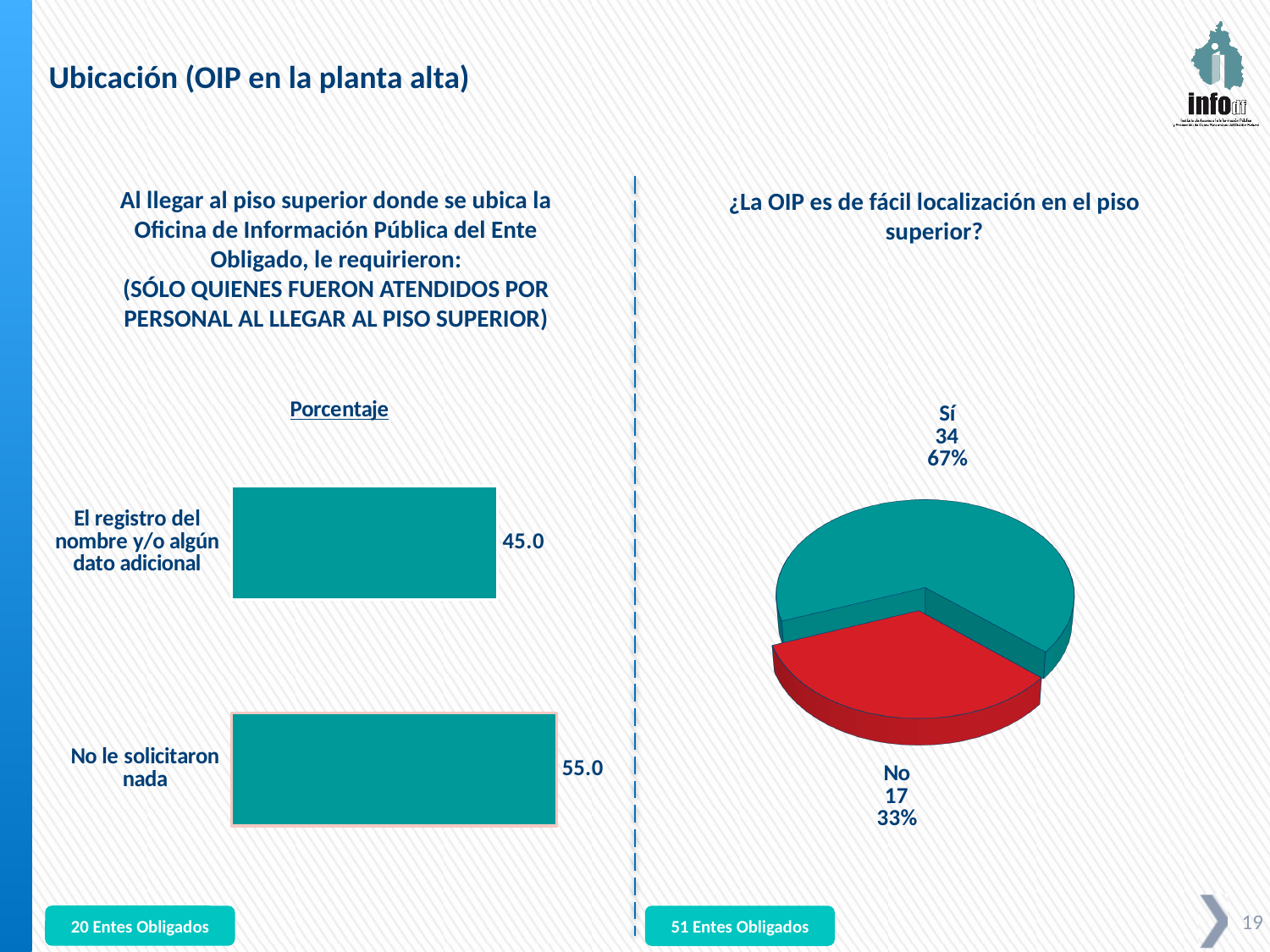
In the right chart '¿La OIP es de fácil localización en el piso superior?', what is the count for 'No'? 17 In the left chart, which category has the lowest value? El registro del nombre y/o algún dato adicional In the left chart, what is the value for 'El registro del nombre y/o algún dato adicional'? 45.0 In the right chart '¿La OIP es de fácil localización en el piso superior?', which slice is larger, 'Sí' or 'No'? Sí In the left chart, which category has the highest value? No le solicitaron nada In the left chart, what is the difference between 'No le solicitaron nada' and 'El registro del nombre y/o algún dato adicional'? 10.0 In the left chart, what is the value for 'No le solicitaron nada'? 55.0 In the right chart '¿La OIP es de fácil localización en el piso superior?', what percentage share does 'Sí' have? 67% What kind of chart is the left chart? Bar chart In the left chart, how many categories are shown? 2 What kind of chart is the right chart? Pie chart In the right chart, what colour is the 'No' slice? Red